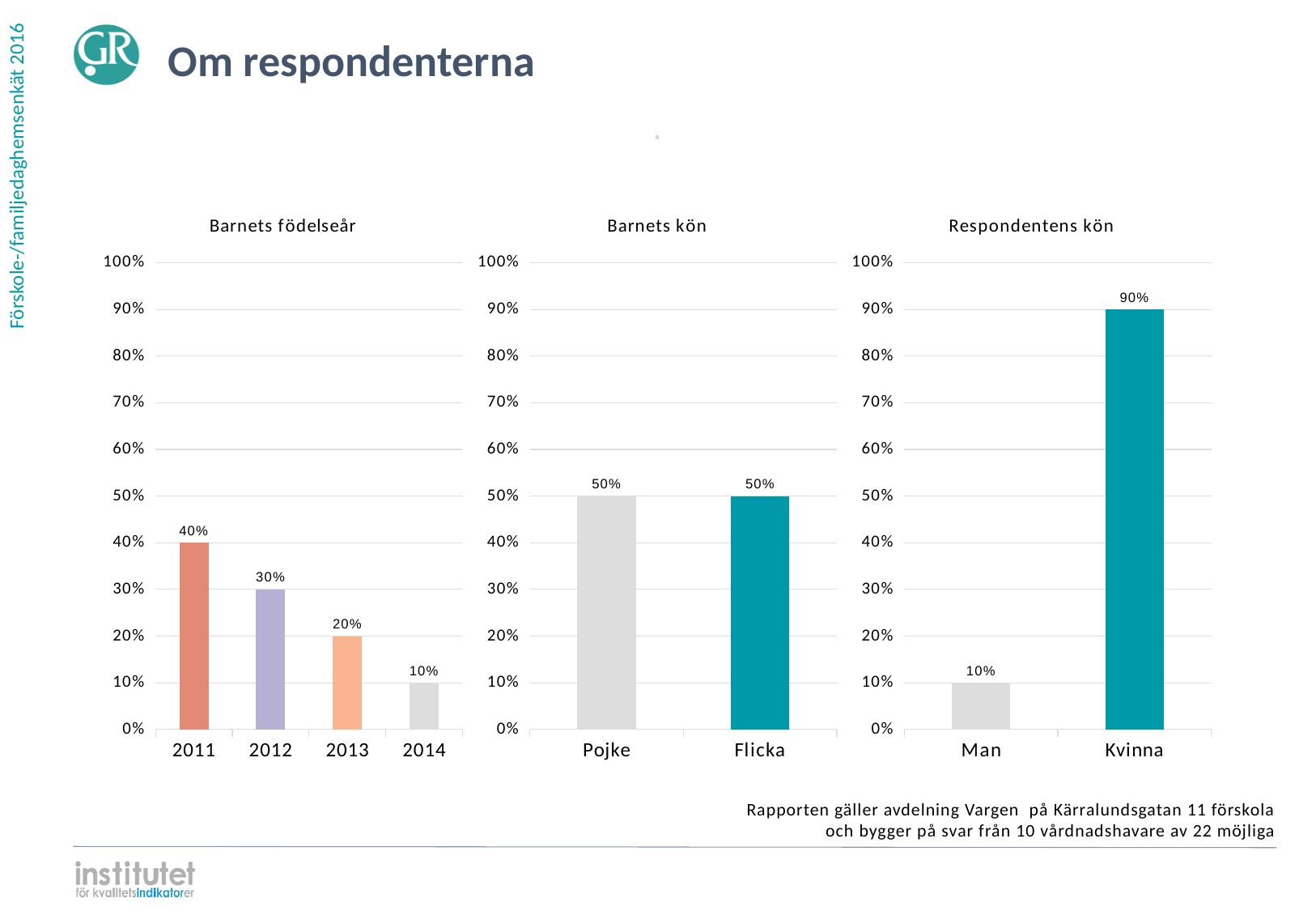
In the 'Respondentens kön' chart, what is the value for Kvinna? 90% In the 'Barnets födelseår' chart, how many birth years are shown? 4 In the 'Barnets födelseår' chart, which birth year has the highest value? 2011 In the 'Barnets kön' chart, what is the value for Pojke? 50% In the 'Barnets födelseår' chart, do the values rise or fall from 2011 to 2014? fall In the 'Barnets födelseår' chart, what is the value for 2011? 40% What kind of chart is the 'Respondentens kön' chart? bar chart In the 'Respondentens kön' chart, which category is larger, Man or Kvinna? Kvinna In the 'Barnets födelseår' chart, what is the difference between the values for 2012 and 2013? 10% In the 'Barnets kön' chart, what is the difference between the values for Pojke and Flicka? 0% In the 'Barnets födelseår' chart, which birth year has the lowest value? 2014 In the 'Respondentens kön' chart, what is the difference between the values for Kvinna and Man? 80%